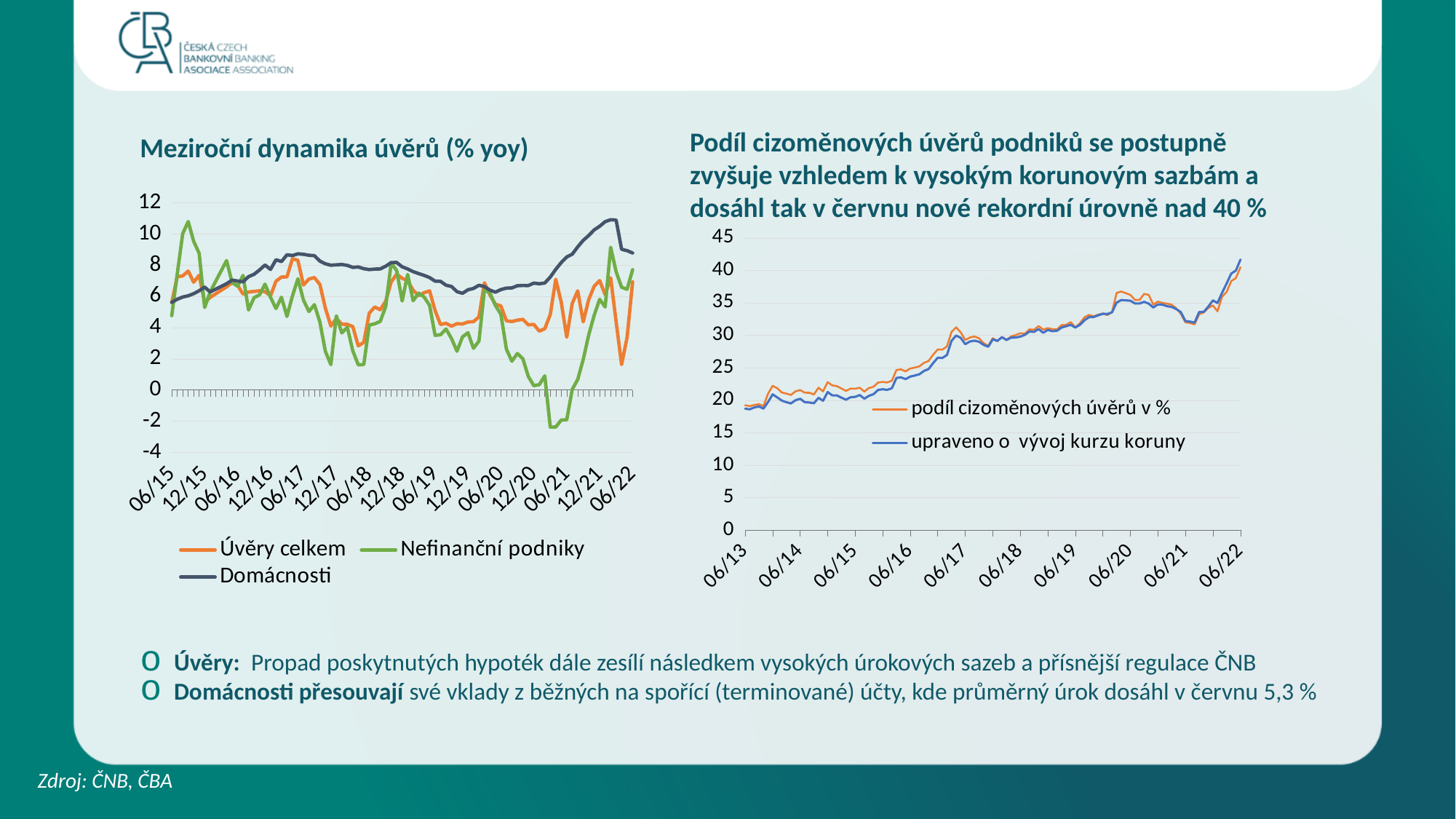
In the left chart 'Meziroční dynamika úvěrů (% yoy)', is the value for Nefinanční podniky at 06/21 greater or less than 0? less In the right chart about 'Podíl cizoměnových úvěrů podniků', do the values generally rise or fall from 06/13 to 06/22? rise How many series does the legend of the left chart 'Meziroční dynamika úvěrů (% yoy)' list? 3 In the left chart 'Meziroční dynamika úvěrů (% yoy)', is the value for Domácnosti at 06/22 greater or less than 8? greater What type of chart is the left chart titled 'Meziroční dynamika úvěrů (% yoy)'? line chart In the right chart about 'Podíl cizoměnových úvěrů podniků', is the value for 'podíl cizoměnových úvěrů v %' at 06/22 greater or less than 40? greater In the left chart 'Meziroční dynamika úvěrů (% yoy)', which series is shown in green? Nefinanční podniky In the left chart 'Meziroční dynamika úvěrů (% yoy)', which is larger at 06/21: Domácnosti or Nefinanční podniky? Domácnosti In the right chart about 'Podíl cizoměnových úvěrů podniků', which series is shown in blue? upraveno o vývoj kurzu koruny How many series does the legend of the right chart about 'Podíl cizoměnových úvěrů podniků' list? 2